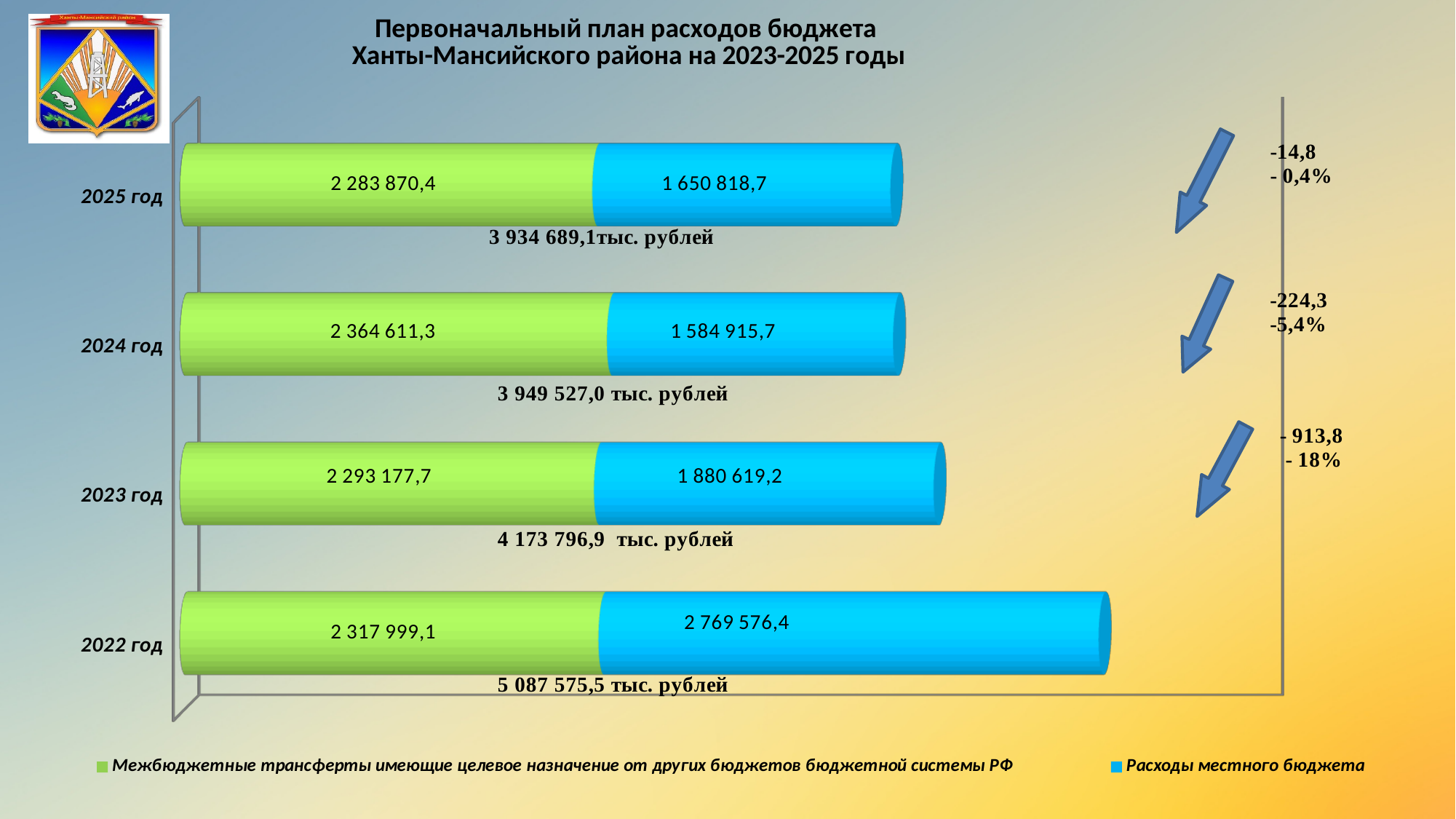
What is the value of 'Расходы местного бюджета' for 2025 год? 1 650 818,7 What kind of chart is shown on the slide? Stacked bar chart What is the total planned expenditure for 2022 год? 5 087 575,5 тыс. рублей How many years are shown in the chart? 4 For 2023 год, which is larger: 'Межбюджетные трансферты' or 'Расходы местного бюджета'? Межбюджетные трансферты Which year has the highest value for 'Расходы местного бюджета'? 2022 год What is the value of 'Межбюджетные трансферты имеющие целевое назначение от других бюджетов бюджетной системы РФ' for 2024 год? 2 364 611,3 What is the value of 'Расходы местного бюджета' for 2022 год? 2 769 576,4 What is the difference between 'Расходы местного бюджета' in 2022 год and in 2025 год? 1 118 757,7 How many series does the legend list? 2 Which colour represents 'Расходы местного бюджета' in the legend? Blue Which year has the lowest value for 'Расходы местного бюджета'? 2024 год